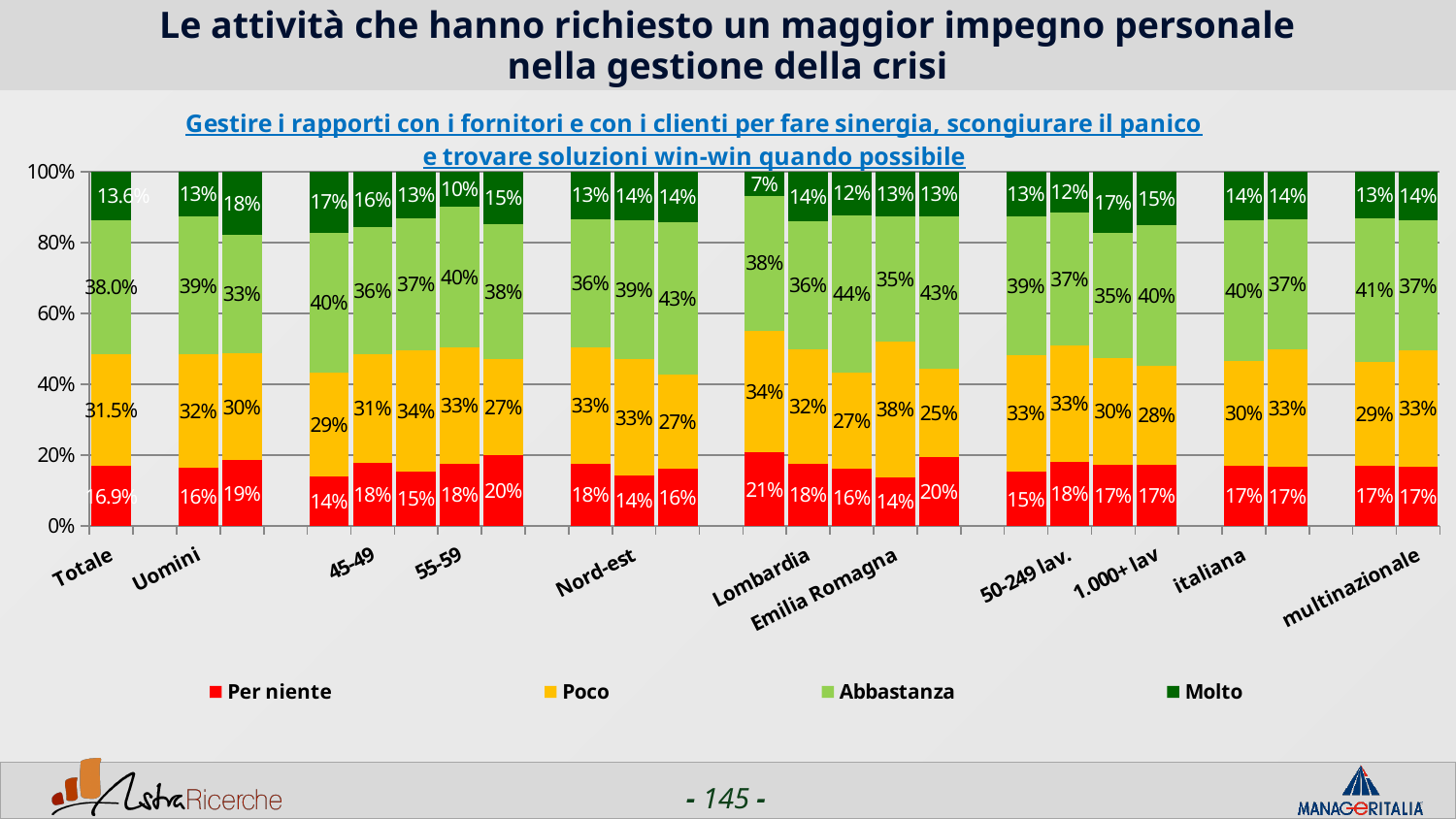
What is the Molto value for Uomini? 13% What is the Molto value for the 55-59 category? 10% What is the Poco value for Emilia Romagna? 38% How many series does the legend list? 4 What is the Per niente value for Totale? 16.9% What percentage of the Totale bar is Abbastanza? 38.0% What is the Per niente value for Nord-est? 14% For Uomini, which is larger: the Abbastanza value or the Poco value? Abbastanza Which legend entry is shown in red? Per niente What is the Poco value for Uomini? 32% For Totale, what is the difference between the Abbastanza value and the Poco value? 6.5 percentage points What kind of chart is shown on the slide? Stacked bar chart